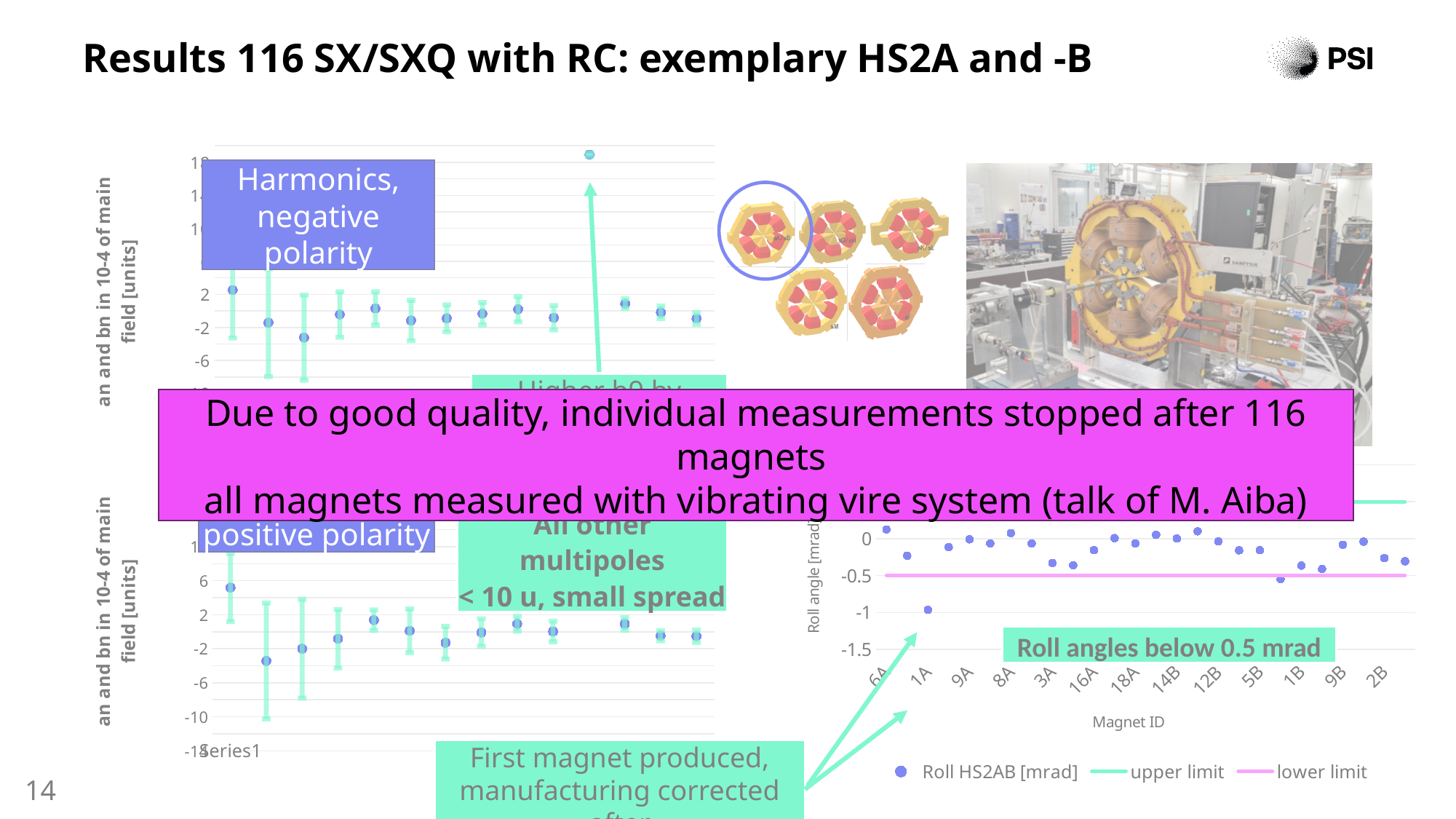
On the top-left chart (harmonics, negative polarity), is the highest plotted point greater or less than 14? greater On the bottom-left chart (harmonics, positive polarity), is the second plotted point greater or less than -2? less On the bottom-right chart, how many magnet ID labels are shown along the x-axis? 13 What series name appears in the legend of the bottom-left chart? Series1 What kind of chart is the bottom-right chart of roll angle versus Magnet ID? scatter chart On the bottom-right chart, how many entries does the legend list? 3 On the bottom-right chart, what is the x-axis title? Magnet ID On the bottom-right chart, is the lowest plotted roll angle greater or less than -0.5? less On the bottom-right chart, what is the name of the plotted data series shown with dots in the legend? Roll HS2AB [mrad] On the bottom-right chart, at what value does the lower limit line sit on the y-axis? -0.5